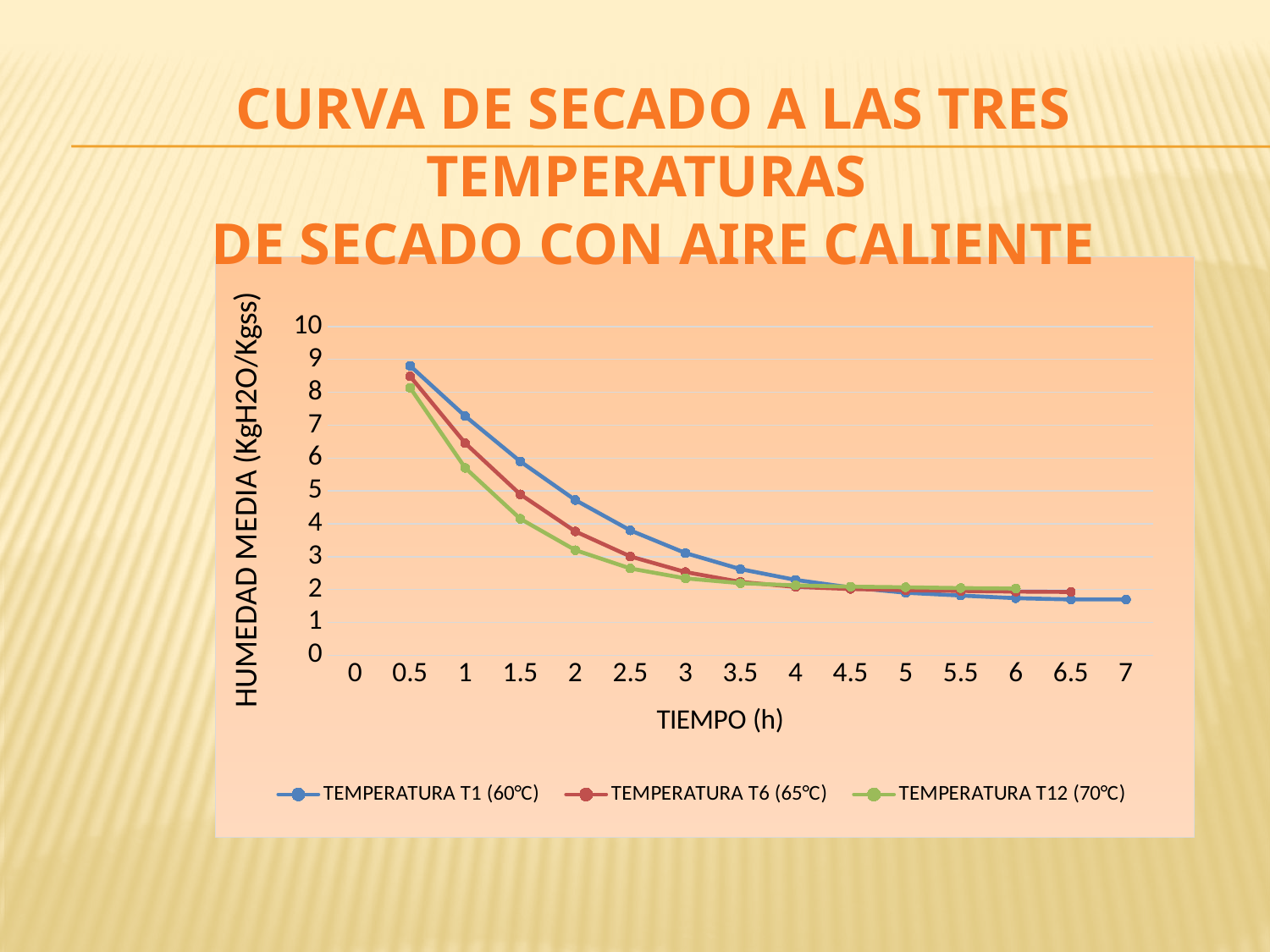
What is the title of the y axis? HUMEDAD MEDIA (KgH2O/Kgss) Do the values of the TEMPERATURA T1 (60°C) series rise or fall as time increases along the x axis? fall Which series has the highest value at 1.5 h? TEMPERATURA T1 (60°C) Is the value for TEMPERATURA T12 (70°C) at 2 h greater or less than 4? less Is the value for TEMPERATURA T1 (60°C) at 1.5 h greater or less than 5? greater What kind of chart is shown on the slide? line chart Is the value for TEMPERATURA T1 (60°C) at 0.5 h greater or less than 8? greater How many series does the legend list? 3 At 1 h, which is larger: the value for TEMPERATURA T1 (60°C) or TEMPERATURA T12 (70°C)? TEMPERATURA T1 (60°C) What colour is the line for TEMPERATURA T12 (70°C)? green Which series has the lowest value at 1 h? TEMPERATURA T12 (70°C) At 2 h, which is larger: the value for TEMPERATURA T6 (65°C) or TEMPERATURA T12 (70°C)? TEMPERATURA T6 (65°C)